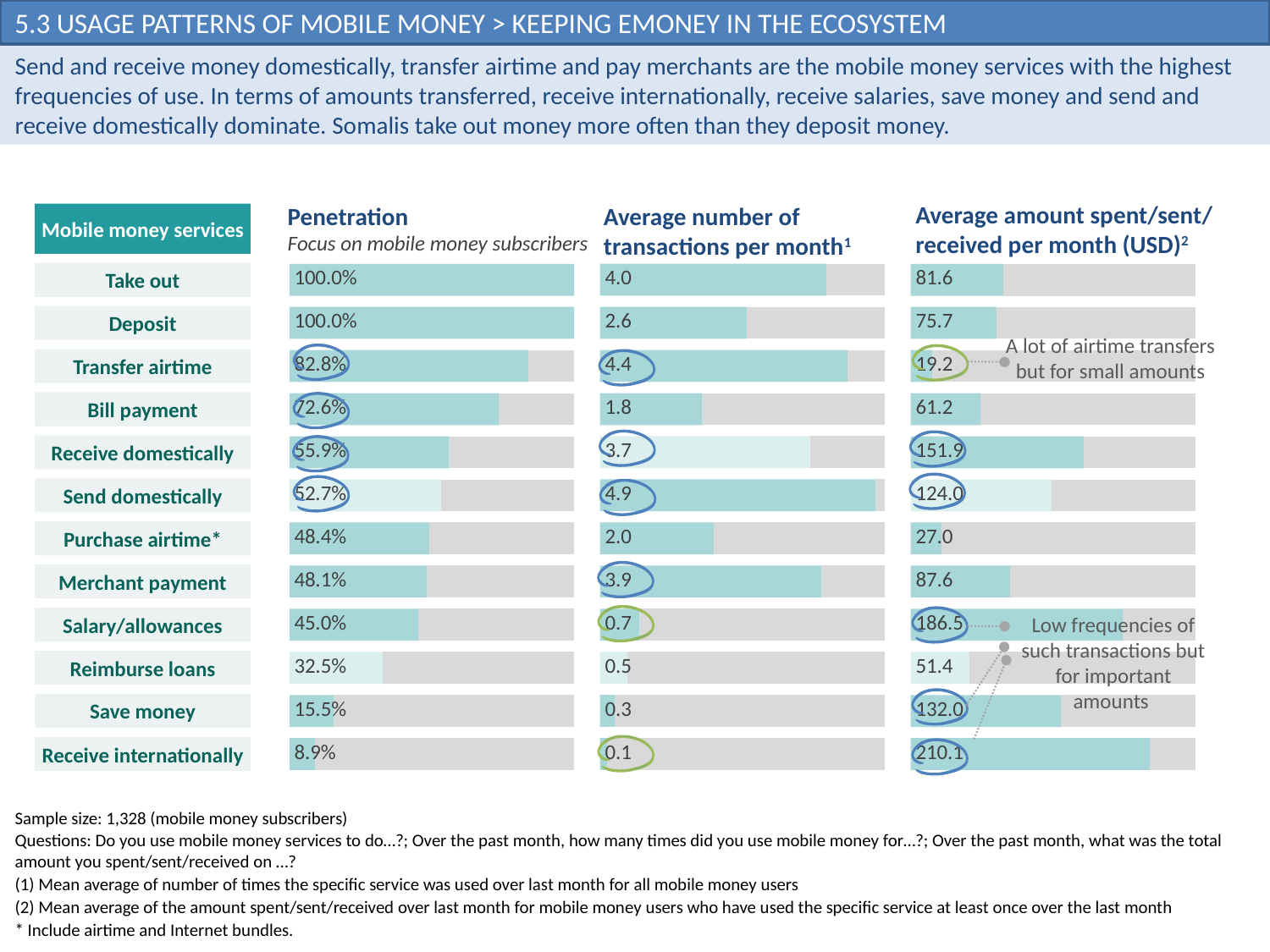
In the Average number of transactions per month chart, which service has the highest value? Send domestically How many mobile money services are listed in the Penetration chart? 12 In the Penetration chart, which service has the lowest value? Receive internationally In the Penetration chart, do the values rise or fall going down the list from Take out to Receive internationally? Fall In the Average amount spent/sent/received per month (USD) chart, what is the value for Save money? 132.0 In the Average amount spent/sent/received per month (USD) chart, what is the difference between Receive domestically and Send domestically? 27.9 In the Penetration chart, what is the value for Bill payment? 72.6% In the Average number of transactions per month chart, what is the value for Merchant payment? 3.9 In the Average number of transactions per month chart, which is larger: Take out or Deposit? Take out What kind of chart is the Penetration chart? Bar chart In the Penetration chart, what is the difference between Transfer airtime and Bill payment? 10.2 percentage points In the Average amount spent/sent/received per month (USD) chart, which service has the highest value? Receive internationally